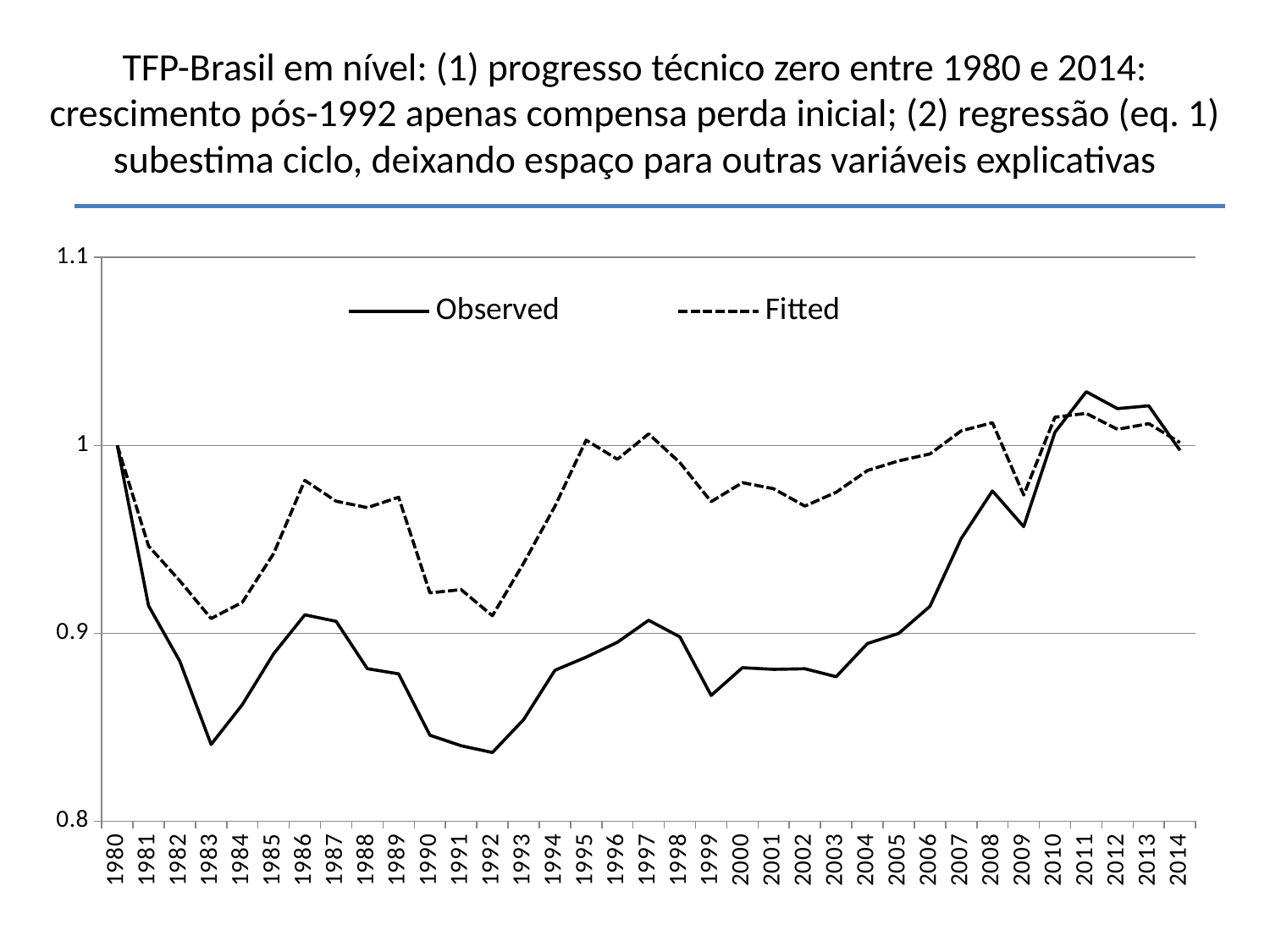
Is the Observed value for 2008 greater or less than 1? less What is the value of the Observed series in 1980? 1 In 1995, which series has the higher value, Observed or Fitted? Fitted Does the Observed series rise or fall between 1980 and 1983? fall Is the Observed value for 2011 greater or less than 1? greater What are the names of the two series in the legend? Observed and Fitted Is the Observed value for 1983 greater or less than 0.9? less Does the Observed series rise or fall between 2003 and 2011? rise How many years are plotted along the x axis? 35 How many series does the legend list? 2 What kind of chart is shown on the slide? line chart